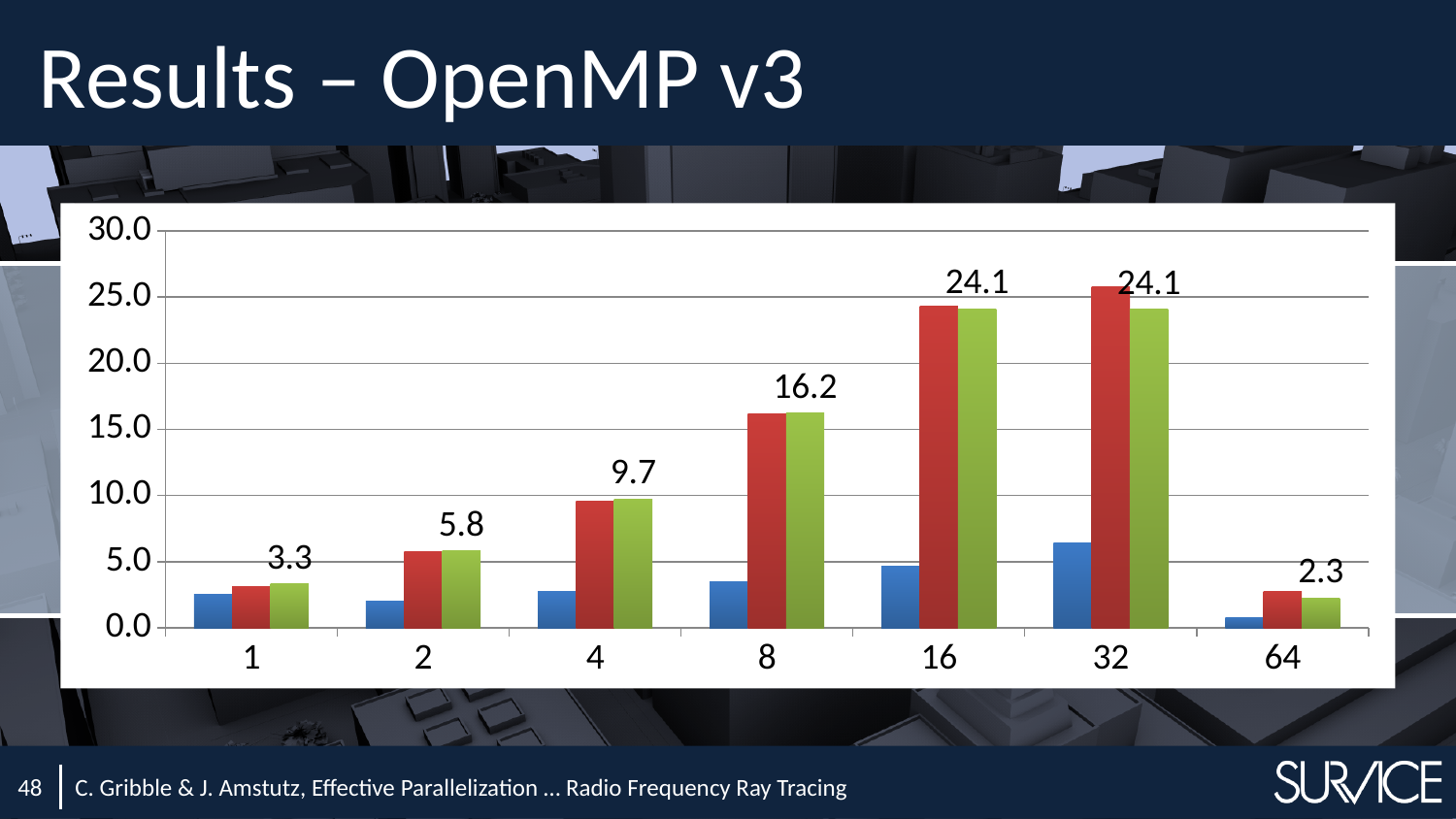
Is the value of the red bar for category 32 greater or less than 25.0? greater Do the labelled green-bar values rise or fall from category 1 to category 32? rise What is the labelled value of the green bar for category 4? 9.7 What is the labelled value of the green bar for category 8? 16.2 What is the difference between the labelled green-bar values for categories 8 and 4? 6.5 What is the labelled value of the green bar for category 64? 2.3 Which category has the lowest labelled green-bar value? 64 How many categories are shown on the x axis? 7 For category 32, which is larger, the red bar or the green bar? red bar What is the difference between the labelled green-bar values for categories 2 and 1? 2.5 What type of chart is shown on the slide? bar chart Is the value of the blue bar for category 8 greater or less than 5.0? less